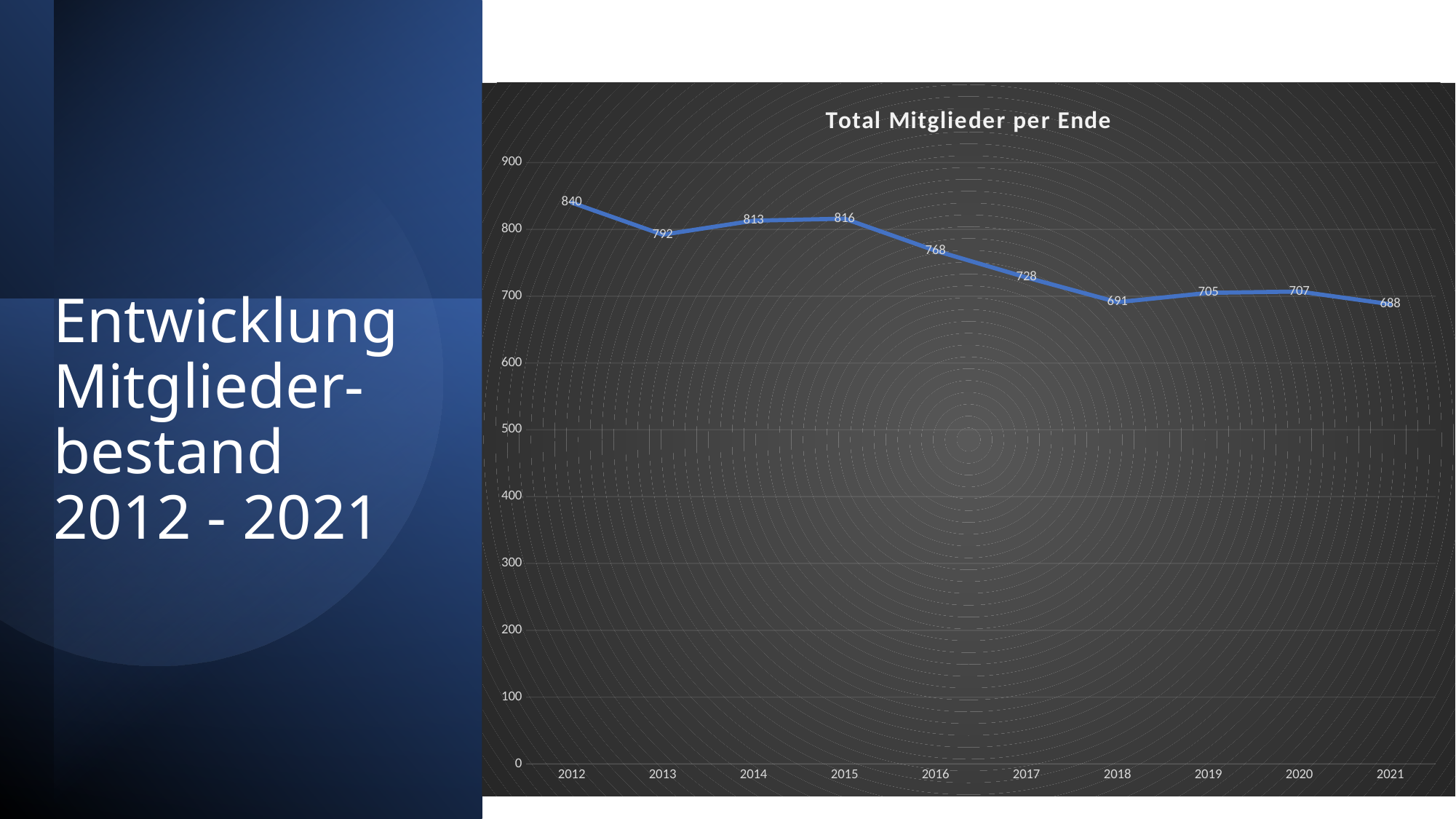
What is the title of the chart? Total Mitglieder per Ende Which is larger, the value for 2013 or the value for 2014? 2014 What is the value for 2018? 691 What is the value for 2012? 840 Is the value for 2017 greater or less than 700? greater What is the value for 2021? 688 Which year has the lowest value? 2021 What is the difference between the values for 2015 and 2016? 48 How many years are plotted on the x axis? 10 Which year has the highest value? 2012 What kind of chart is shown? line chart What is the difference between the values for 2012 and 2021? 152